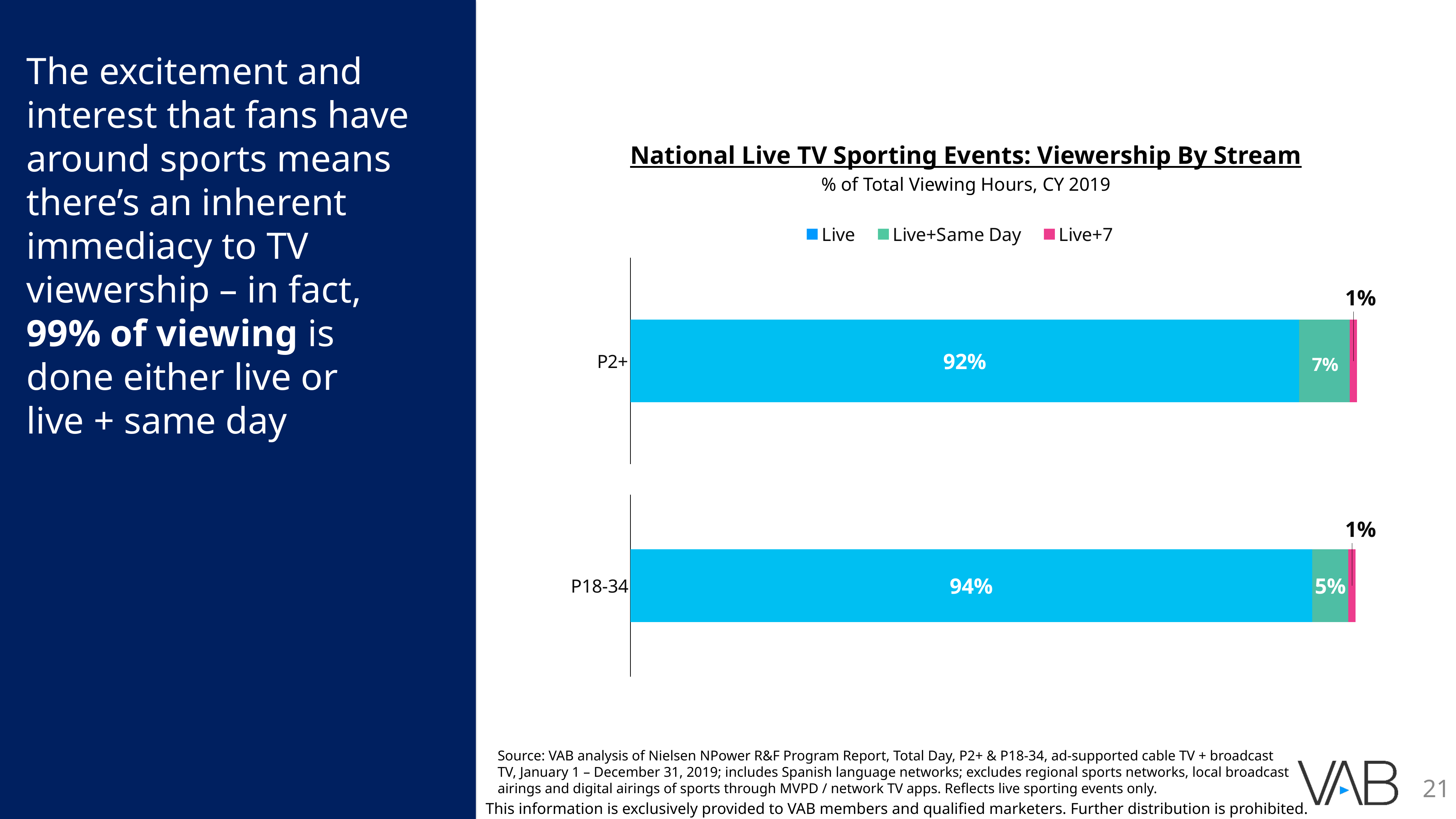
What is the Live+7 share of total viewing hours for P2+? 1% What is the total of the three stream shares shown for the P2+ bar? 100% What is the Live share of total viewing hours for P2+? 92% How many demographic categories are shown in the chart? 2 How many series does the legend list? 3 What is the Live share of total viewing hours for P18-34? 94% What kind of chart is shown on the slide? Stacked bar chart What is the Live+Same Day share of total viewing hours for P18-34? 5% What is the title of the chart? National Live TV Sporting Events: Viewership By Stream Which demographic has the higher Live share, P2+ or P18-34? P18-34 What is the difference between the Live+Same Day share for P2+ and for P18-34? 2% What is the difference between the Live share for P18-34 and the Live share for P2+? 2%